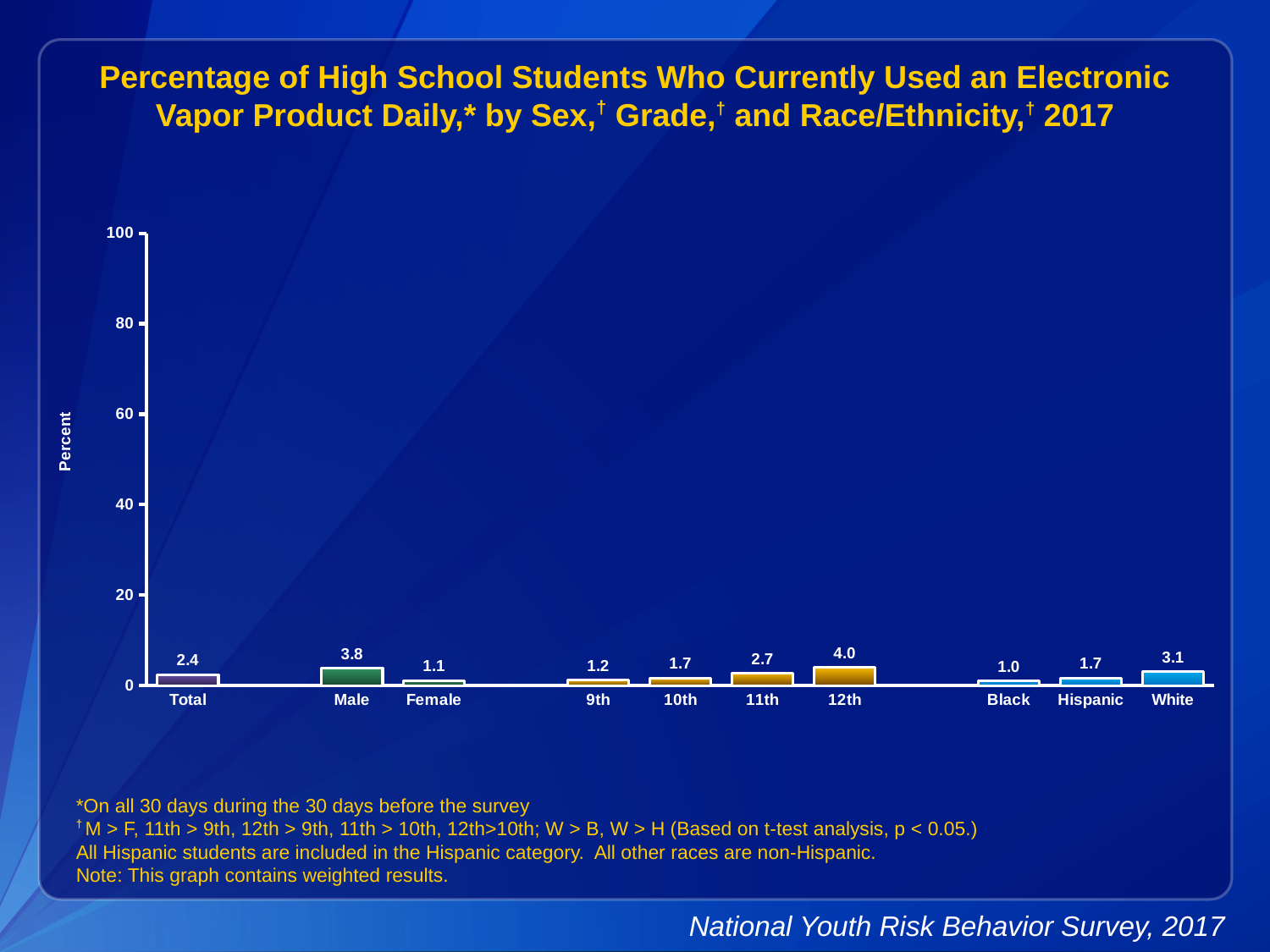
Which category has the lowest value? Black What kind of chart is this? bar chart What is the value for 12th grade? 4.0 Which is larger, the value for 11th grade or the value for Hispanic? 11th What is the value for Total? 2.4 What is the value for Black students? 1.0 What is the difference between the values for White and Black? 2.1 How many categories are shown on the x axis? 10 Which category has the highest value? 12th What is the difference between the values for Male and Female? 2.7 Do the values rise or fall from 9th grade to 12th grade? rise What is the value for Male? 3.8